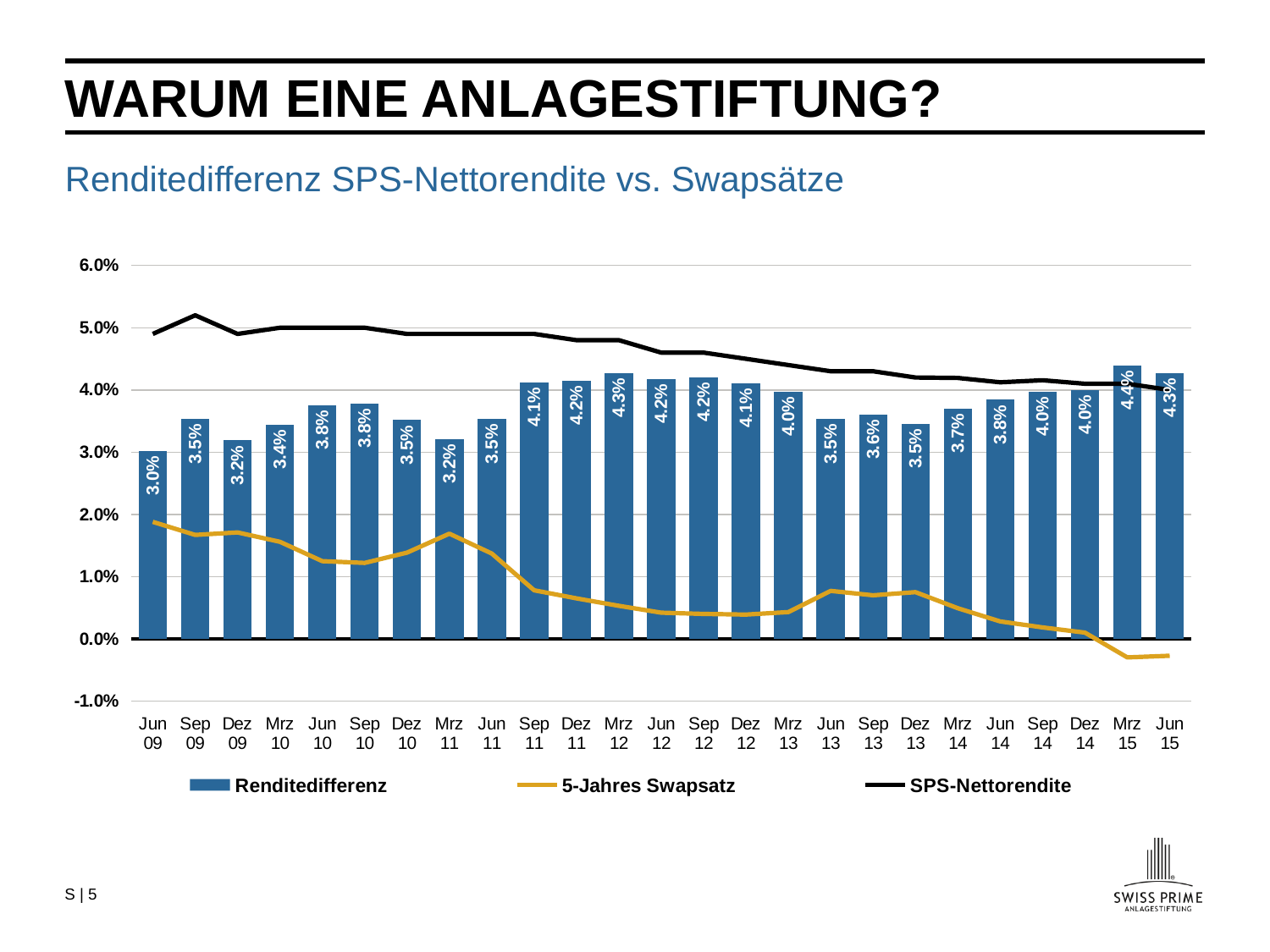
Is the SPS-Nettorendite value for Sep 09 greater or less than 5.0%? greater How many periods are shown on the x axis? 25 What is the Renditedifferenz value for Mrz 12? 4.3% How many series does the legend list? 3 Which period has the highest Renditedifferenz bar? Mrz 15 Which period has the lowest Renditedifferenz bar? Jun 09 What is the Renditedifferenz value for Dez 13? 3.5% Is the 5-Jahres Swapsatz value for Jun 15 greater or less than 0.0%? less What is the Renditedifferenz value for Jun 09? 3.0% Does the 5-Jahres Swapsatz line rise or fall overall from Jun 09 to Jun 15? fall Which is larger, the Renditedifferenz for Sep 09 or for Jun 10? Jun 10 What is the difference between the Renditedifferenz for Mrz 15 and for Jun 09? 1.4%